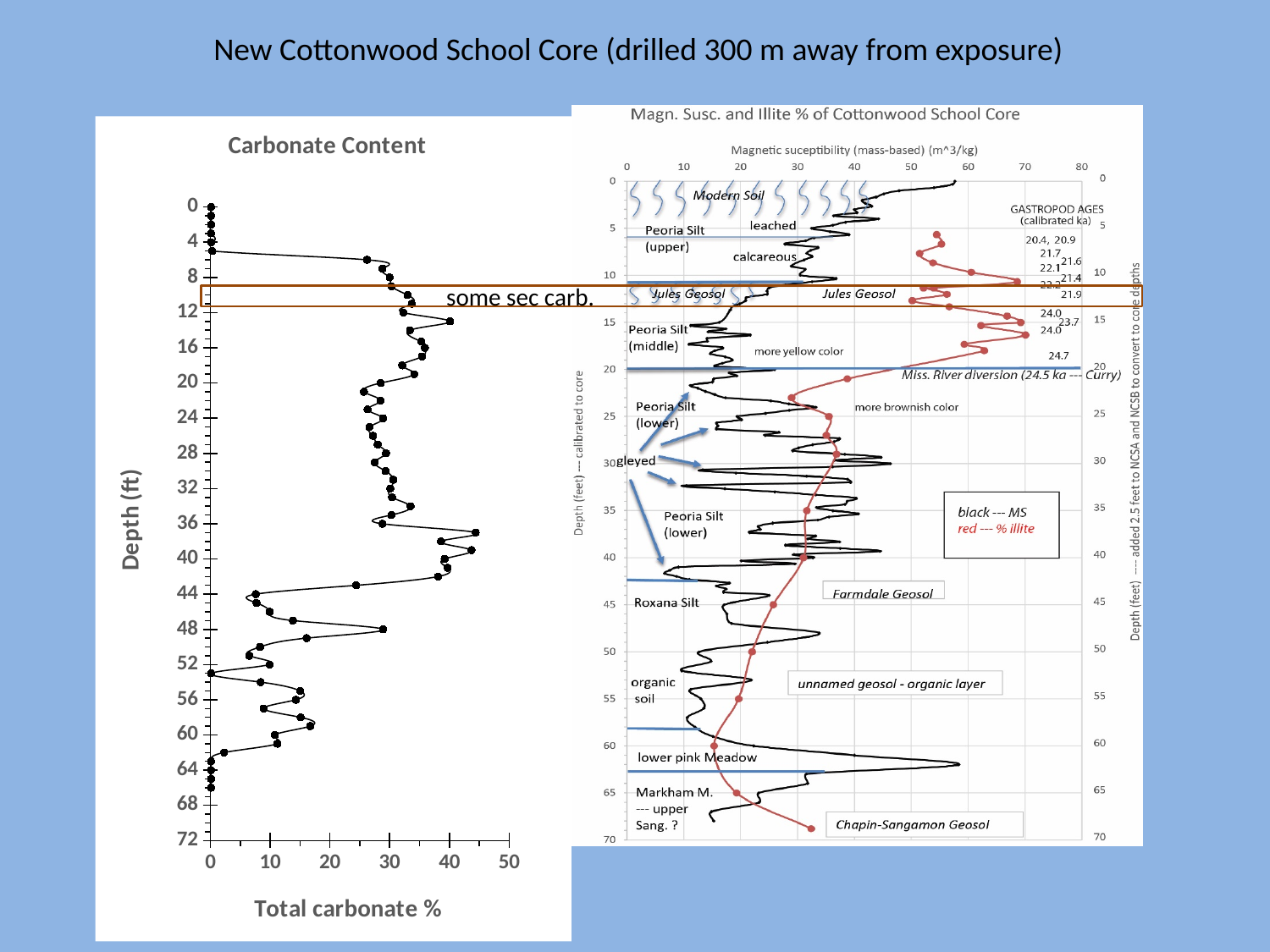
How many series does the legend of the Magn. Susc. and Illite % of Cottonwood School Core chart list? 2 On the Magn. Susc. and Illite % of Cottonwood School Core chart, is the % illite at a depth of 65 ft greater or less than 30? less On the Carbonate Content chart, what is the largest value shown on the Total carbonate % axis? 50 What kind of chart is the Carbonate Content chart on the left? line chart On the Carbonate Content chart, is the total carbonate % at a depth of 8 ft greater or less than 20? greater On the Carbonate Content chart, what is the title of the horizontal axis? Total carbonate % On the Magn. Susc. and Illite % of Cottonwood School Core chart, what age is given for the Miss. River diversion? 24.5 ka On the Magn. Susc. and Illite % of Cottonwood School Core chart, which series is drawn in red? % illite On the Carbonate Content chart, is the total carbonate % at a depth of 44 ft greater or less than 10? less